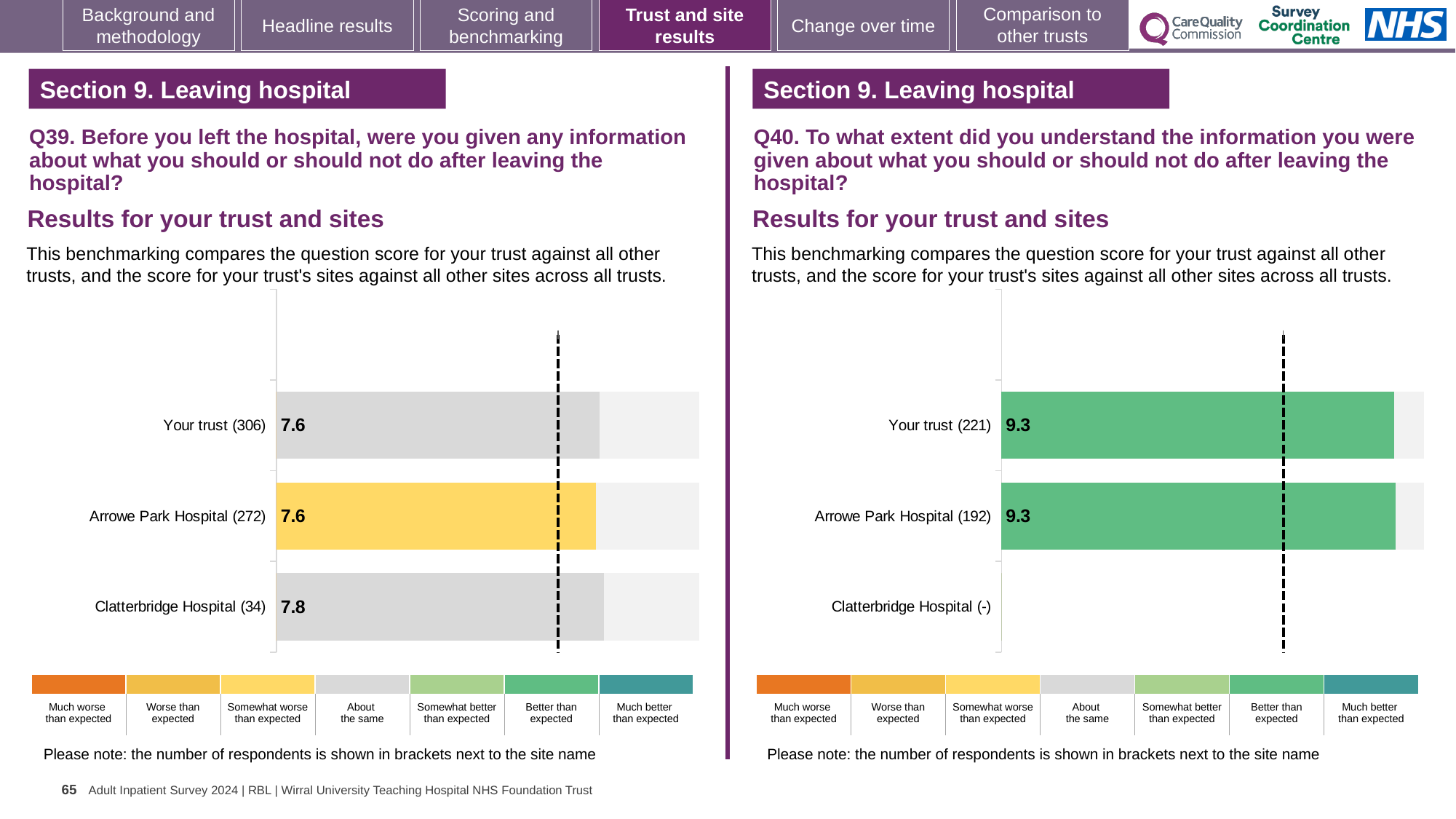
In the Q39 chart on the left, what is the score for Arrowe Park Hospital? 7.6 What kind of chart is used in the Q39 chart on the left? Bar chart In the Q39 chart on the left, what is the difference between the Clatterbridge Hospital score and the Arrowe Park Hospital score? 0.2 How many sites or categories are listed in the Q40 chart on the right? 3 In the Q39 chart on the left, what is the score for Your trust? 7.6 In the Q39 chart on the left, what benchmark category does the colour of the Arrowe Park Hospital bar indicate? Somewhat worse than expected In the Q39 chart on the left, how many respondents are shown for Clatterbridge Hospital? 34 In the Q40 chart on the right, how many respondents are shown for Your trust? 221 In the Q39 chart on the left, what is the score for Clatterbridge Hospital? 7.8 In the Q40 chart on the right, what is the score for Your trust? 9.3 In the Q40 chart on the right, what is the score for Arrowe Park Hospital? 9.3 In the Q39 chart on the left, which site has the highest score? Clatterbridge Hospital